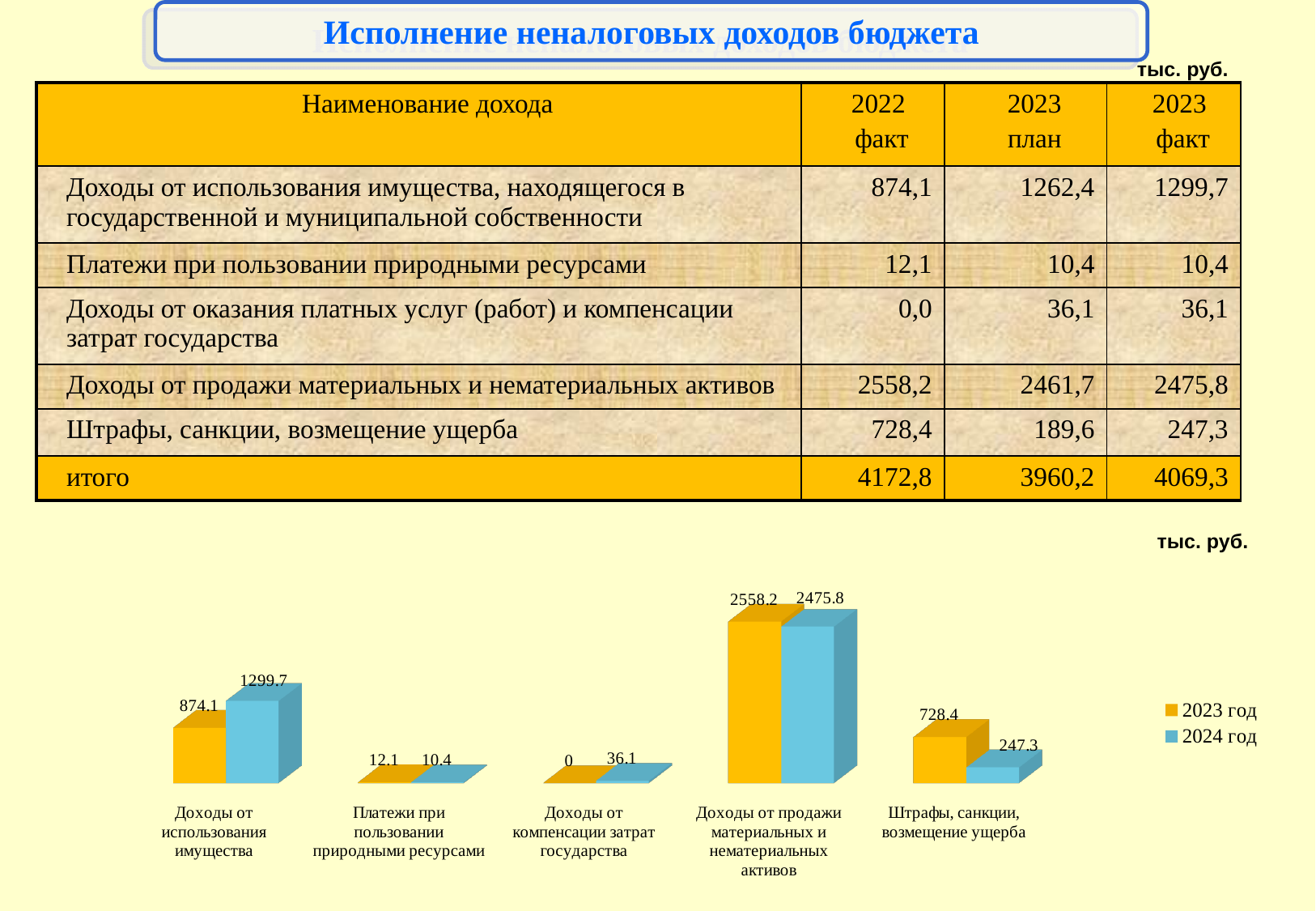
Which series is shown in blue in the chart legend? 2024 год What is the value of the 2023 год bar for Штрафы, санкции, возмещение ущерба? 728.4 What is the value of the 2024 год bar for Доходы от использования имущества? 1299.7 How many series does the chart legend list? 2 Which category has the highest 2023 год value? Доходы от продажи материальных и нематериальных активов What is the difference between the 2023 год and 2024 год values for Штрафы, санкции, возмещение ущерба? 481.1 Which category has the lowest 2023 год value? Доходы от компенсации затрат государства How many categories are shown on the chart's x axis? 5 What is the value of the 2024 год bar for Доходы от компенсации затрат государства? 36.1 For Доходы от продажи материальных и нематериальных активов, which is larger: the 2023 год value or the 2024 год value? 2023 год What kind of chart is shown on the slide? bar chart What is the difference between the 2024 год and 2023 год values for Доходы от использования имущества? 425.6